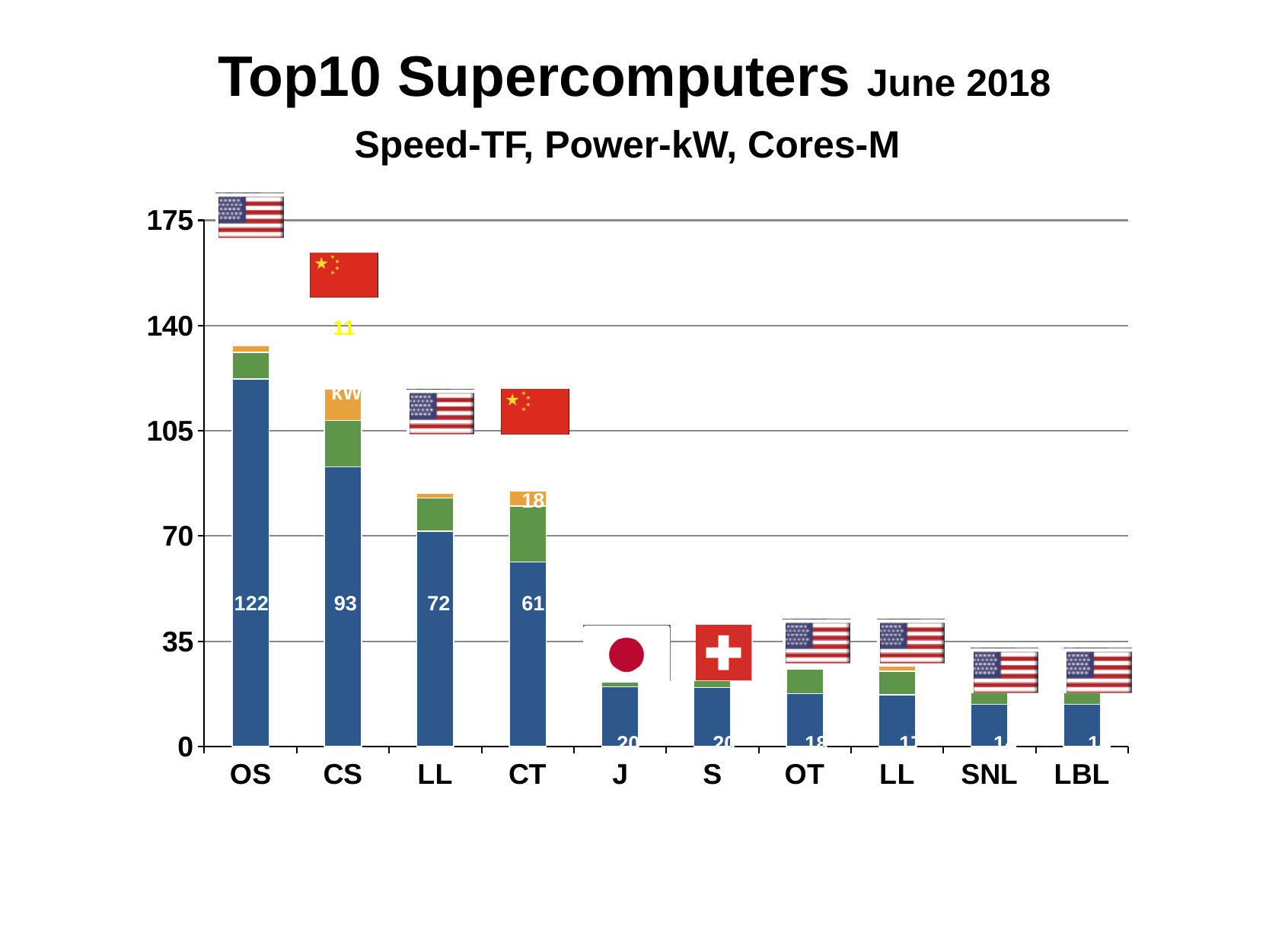
What is the value printed on the blue segment of the OS bar? 122 What is the value printed on the blue segment of the CS bar? 93 What is the value printed on the blue segment of the third bar from the left (LL)? 72 Is the total height of the OS bar greater or less than 105? greater What is the difference between the blue segment values of OS and CS? 29 What kind of chart is shown on the slide? bar chart Which category has the tallest bar? OS Do the bar heights generally rise or fall from left to right along the x axis? fall What is the title of the chart? Top10 Supercomputers June 2018 What is the value printed on the blue segment of the CT bar? 61 Which has the larger blue segment value, CS or CT? CS How many categories are shown along the x axis? 10